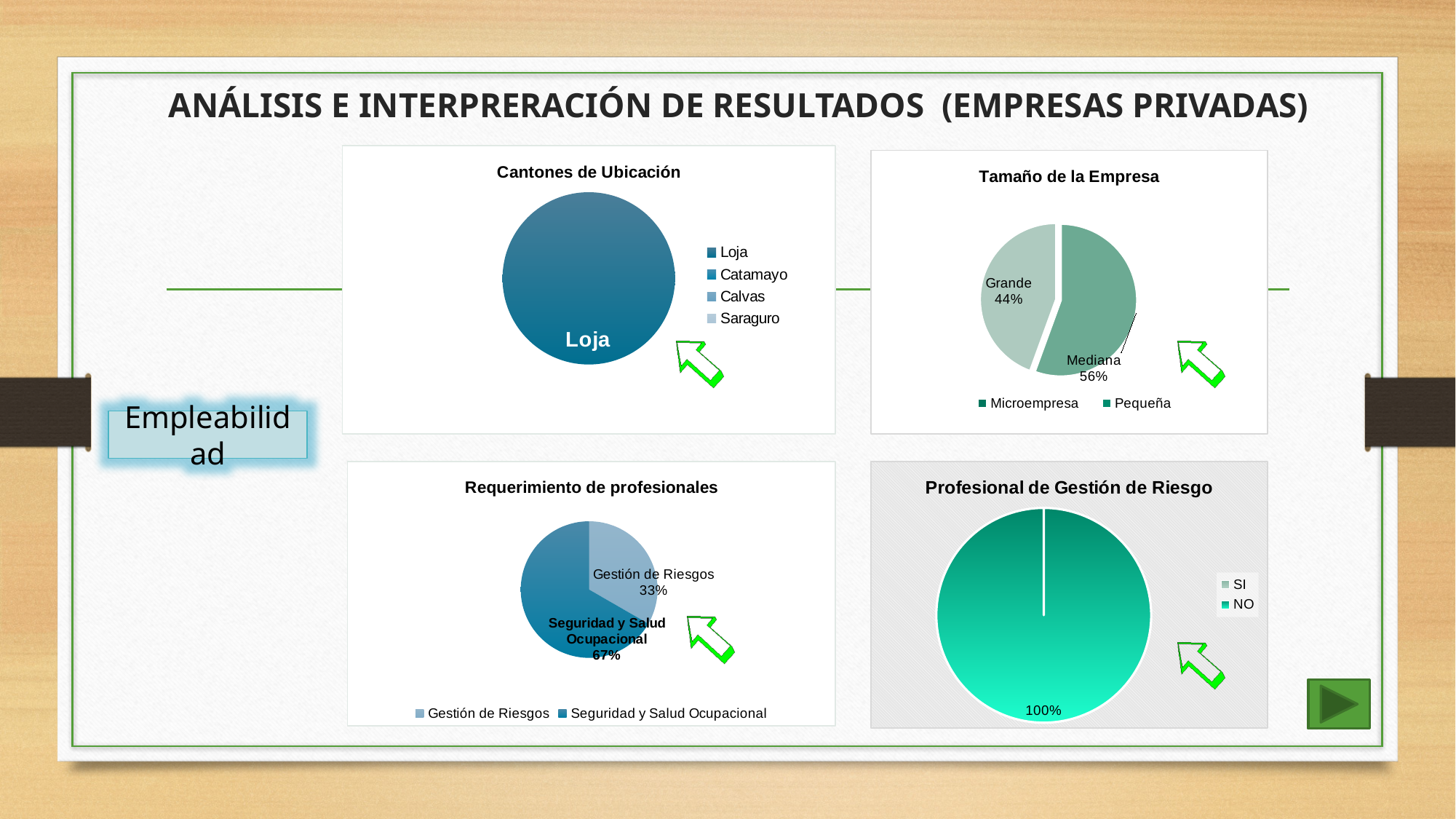
What percentage is printed on the "Profesional de Gestión de Riesgo" chart? 100% In the "Tamaño de la Empresa" chart, what percentage is shown for Mediana? 56% In the "Requerimiento de profesionales" chart, which category has the largest share? Seguridad y Salud Ocupacional In the "Tamaño de la Empresa" chart, what is the difference in percentage points between Mediana and Grande? 12 How many entries does the legend of the "Profesional de Gestión de Riesgo" chart list? 2 In the "Requerimiento de profesionales" chart, what percentage is shown for Gestión de Riesgos? 33% In the "Requerimiento de profesionales" chart, what percentage is shown for Seguridad y Salud Ocupacional? 67% In the "Cantones de Ubicación" chart, which category is labelled on the pie? Loja In the "Tamaño de la Empresa" chart, what percentage is shown for Grande? 44% In the "Tamaño de la Empresa" chart, which slice is larger, Grande or Mediana? Mediana How many entries does the legend of the "Cantones de Ubicación" chart list? 4 What kind of chart is the "Tamaño de la Empresa" chart? pie chart